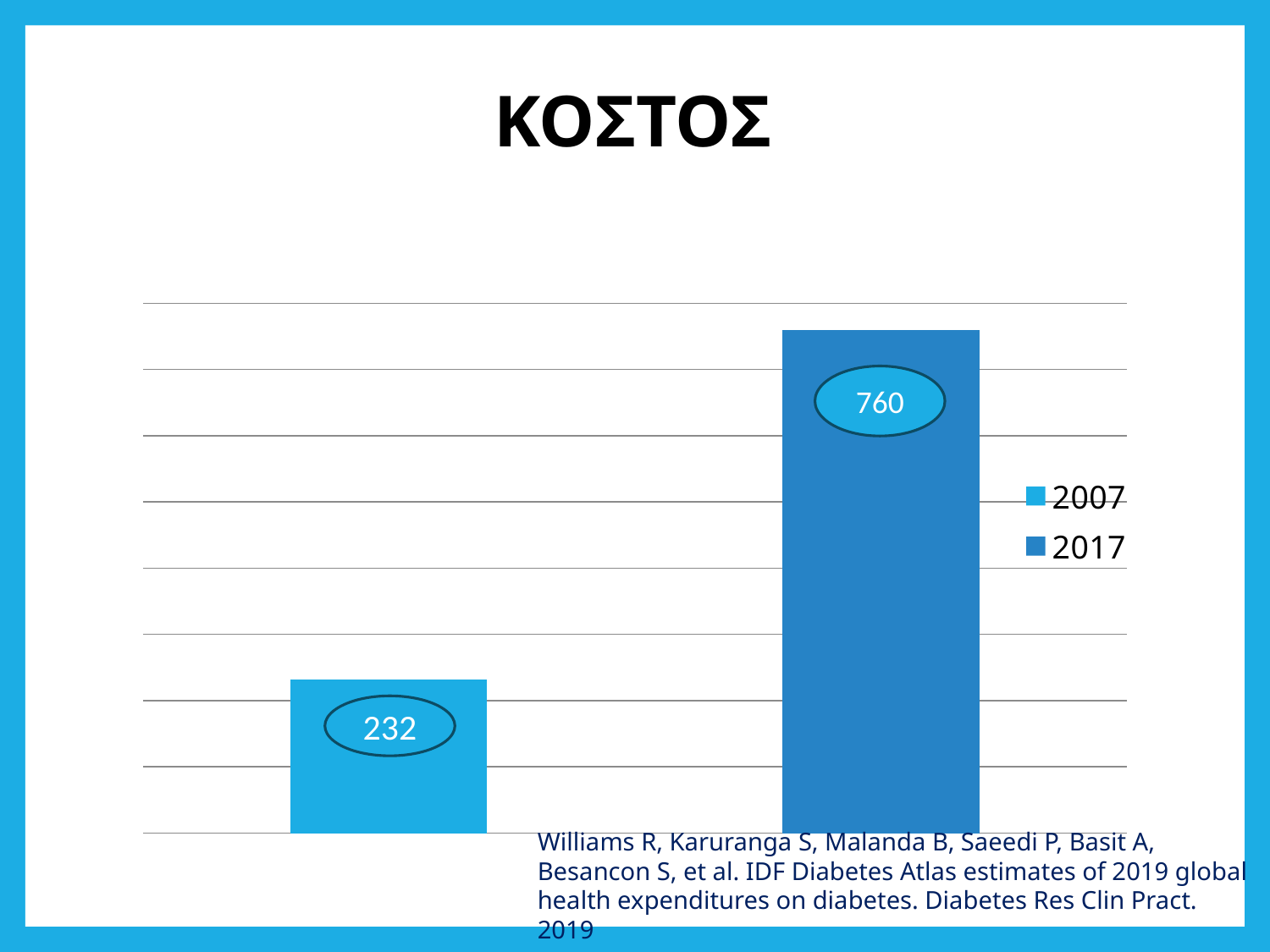
What is the value for 2007? 232 How many entries does the legend list? 2 How many bars are plotted in the chart? 2 Is the value for 2017 larger than the value for 2007? Yes Which year has the higher value? 2017 What is the value for 2017? 760 What kind of chart is shown on the slide? Bar chart Which years are listed in the chart legend? 2007 and 2017 Which year has the lower value? 2007 Do the values rise or fall from 2007 to 2017? Rise What is the title of the slide containing the chart? ΚΟΣΤΟΣ What is the difference between the 2017 value and the 2007 value? 528